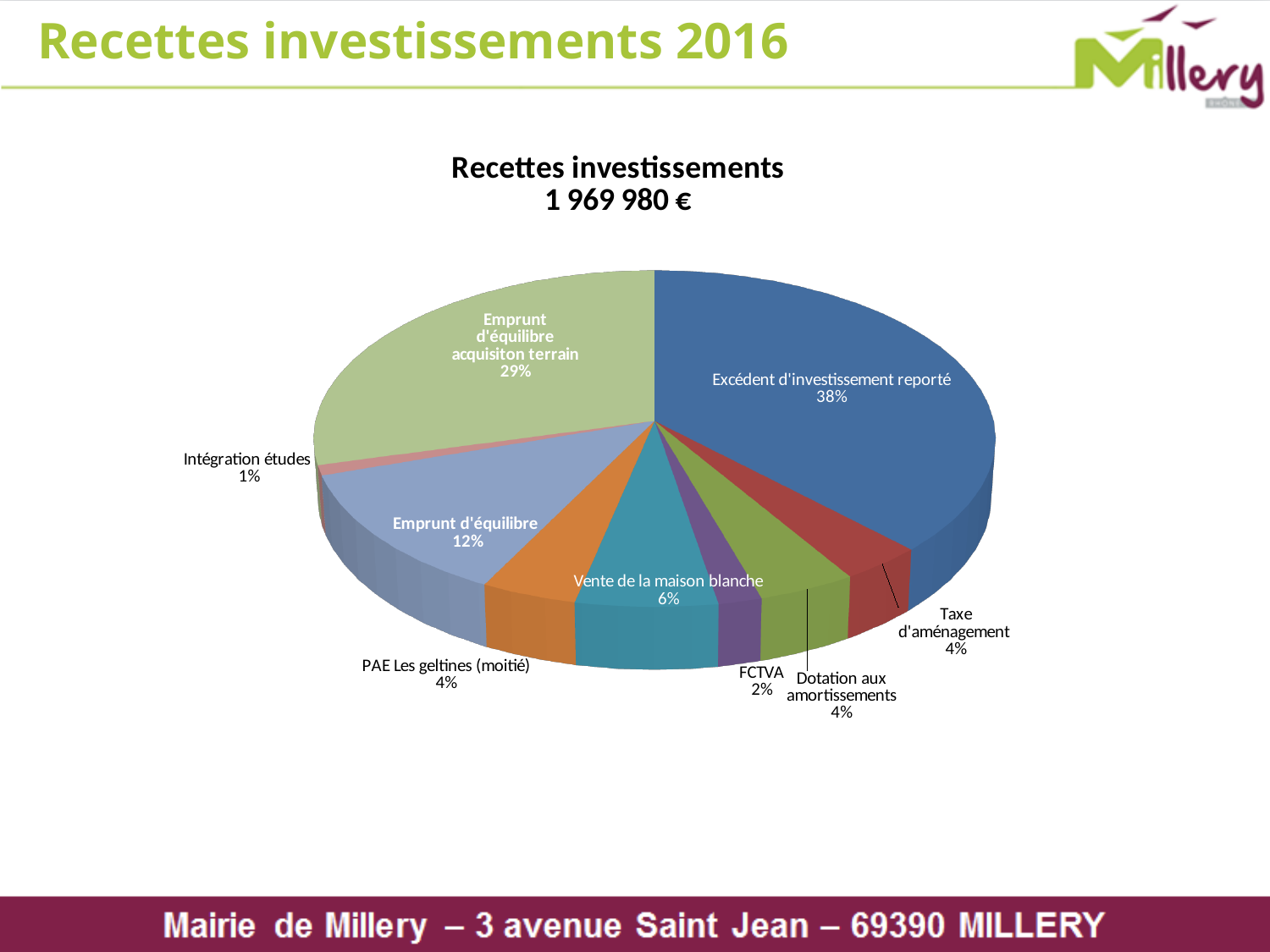
Which category has the largest share of the pie? Excédent d'investissement reporté Which category has the smallest share of the pie? Intégration études What share of the pie does Excédent d'investissement reporté represent? 38% What kind of chart is shown on the slide? Pie chart How many categories are shown in the pie chart? 9 What is the value shown for Emprunt d'équilibre? 12% What is the value shown for FCTVA? 2% What is the difference in percentage points between Excédent d'investissement reporté and Emprunt d'équilibre acquisiton terrain? 9 Which is larger, the share for Emprunt d'équilibre or the share for Vente de la maison blanche? Emprunt d'équilibre What is the title of the chart? Recettes investissements 1 969 980 € What share of the pie does Emprunt d'équilibre acquisiton terrain represent? 29% What is the value shown for Vente de la maison blanche? 6%